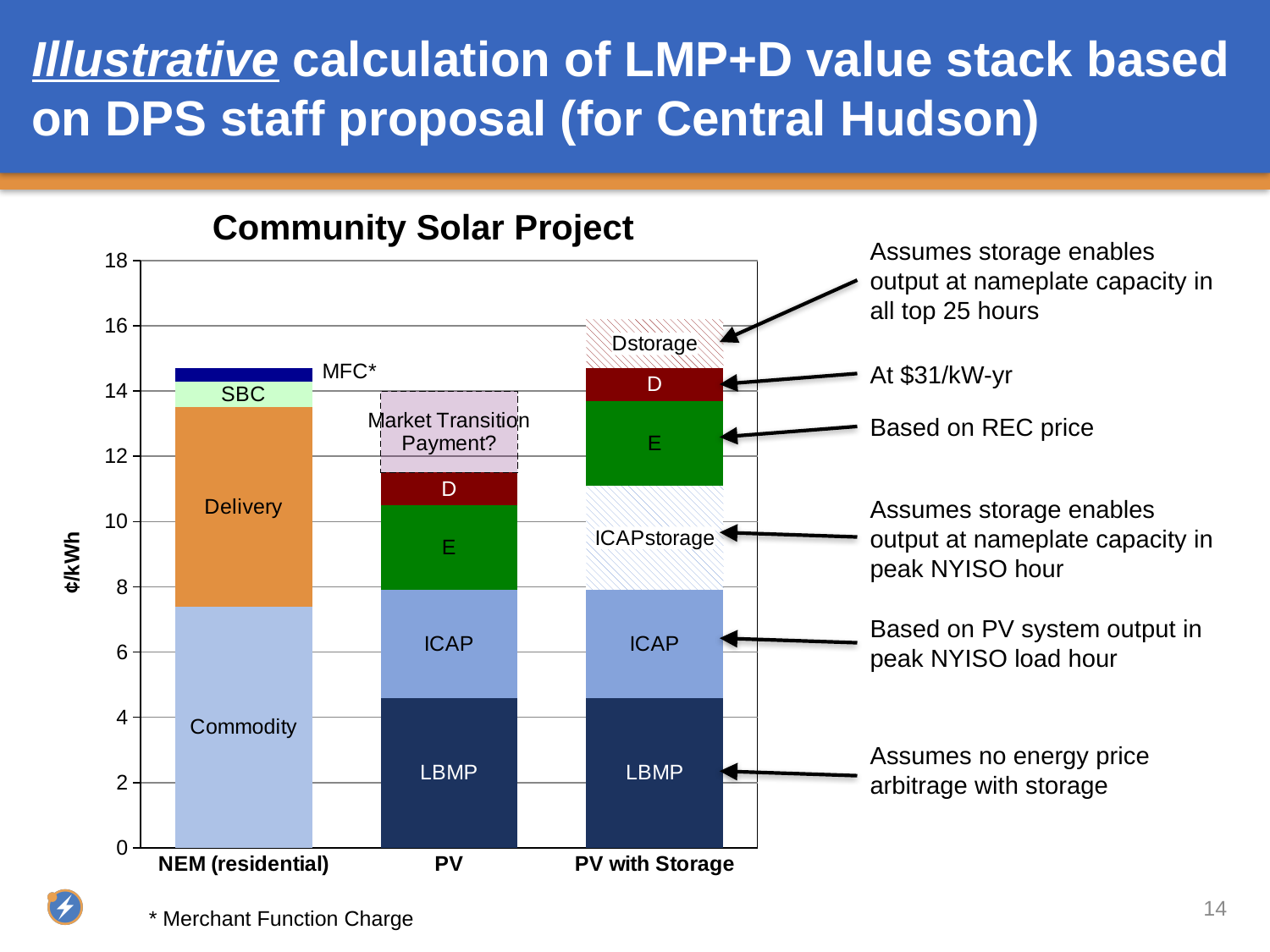
What kind of chart is shown on the slide? Stacked bar chart Which bar has the lowest total value? PV Is the total value for NEM (residential) greater or less than 14? greater Which bar reaches the highest total value? PV with Storage What is the label on the y axis of the chart? ¢/kWh Which is larger in the PV bar, the E segment or the D segment? E Is the top of the Commodity segment in the NEM (residential) bar greater or less than 8? less Which bar has a higher total, NEM (residential) or PV? NEM (residential) How many categories (bars) are shown on the x axis of the chart? 3 What is the title of the chart? Community Solar Project Is the total value for PV with Storage greater or less than 14? greater